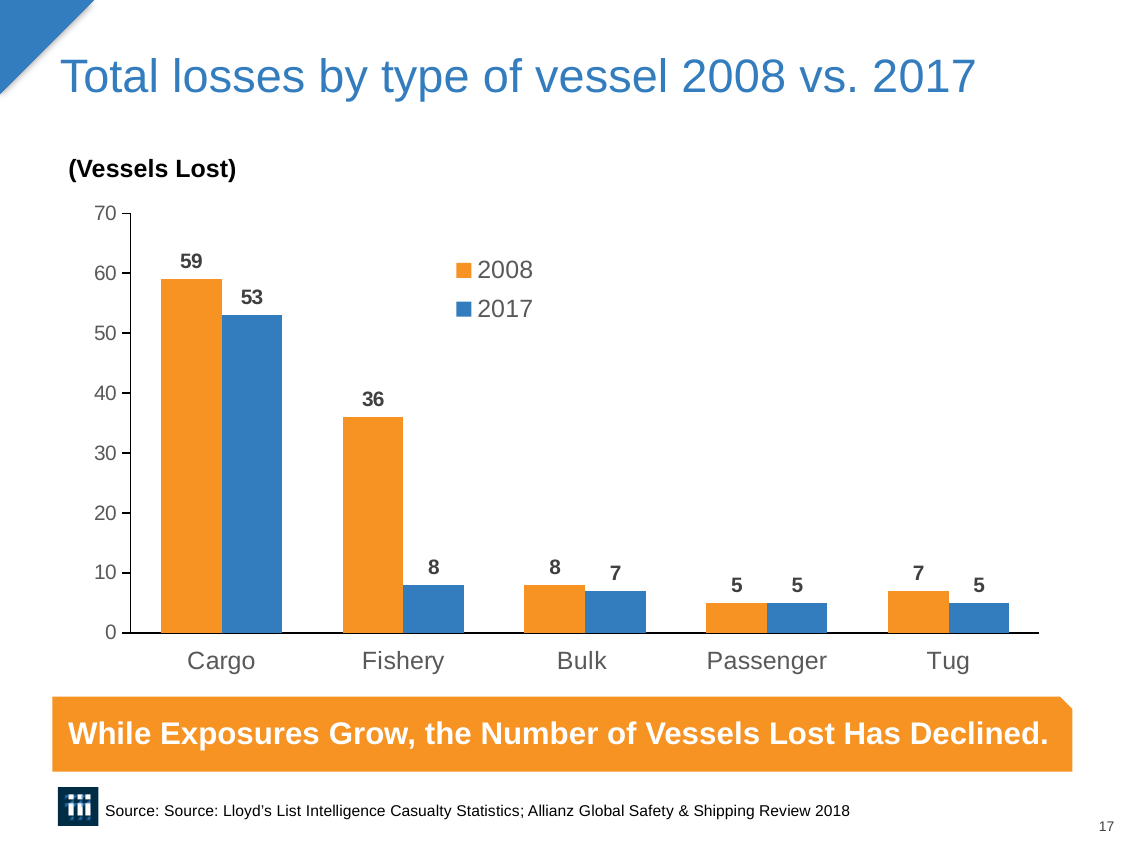
What kind of chart is shown on the slide? Bar chart Is the 2017 value for Cargo greater or less than 50? greater Which colour represents the 2017 series? Blue Which vessel type had the highest number of losses in 2008? Cargo Which is larger, the 2008 value for Bulk or the 2008 value for Tug? Bulk (8) How many series does the legend list? 2 What is the value for Fishery in 2017? 8 Which vessel type had the lowest number of losses in 2017? Passenger and Tug (both 5) What is the difference between the 2008 and 2017 values for Cargo? 6 How many vessel types are shown on the x axis? 5 How many cargo vessels were lost in 2008? 59 What is the difference between the 2008 and 2017 values for Fishery? 28